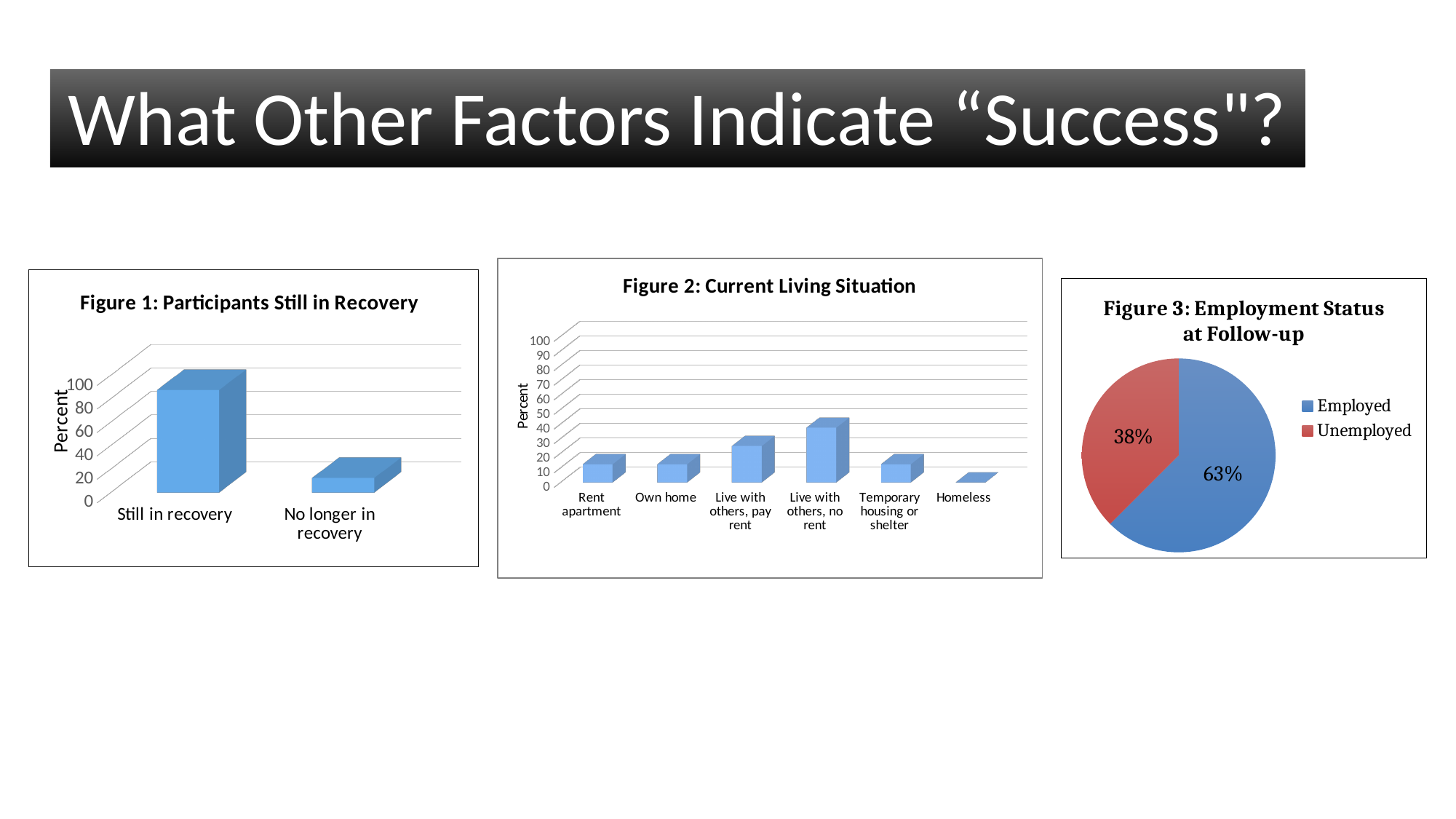
In Figure 2: Current Living Situation, which category has the lowest value? Homeless In Figure 3: Employment Status at Follow-up, what percentage of participants are Unemployed? 38% In Figure 1: Participants Still in Recovery, what kind of chart is shown? bar chart In Figure 2: Current Living Situation, which is larger, the value for Live with others, pay rent or the value for Own home? Live with others, pay rent In Figure 1: Participants Still in Recovery, is the value for No longer in recovery greater or less than 20? less In Figure 2: Current Living Situation, which category has the highest value? Live with others, no rent In Figure 2: Current Living Situation, is the value for Live with others, no rent greater or less than 30? greater In Figure 3: Employment Status at Follow-up, how many entries does the legend list? 2 In Figure 1: Participants Still in Recovery, which category has the higher value? Still in recovery In Figure 3: Employment Status at Follow-up, what percentage of participants are Employed? 63% In Figure 2: Current Living Situation, how many categories are shown on the x axis? 6 In Figure 1: Participants Still in Recovery, is the value for Still in recovery greater or less than 80? greater